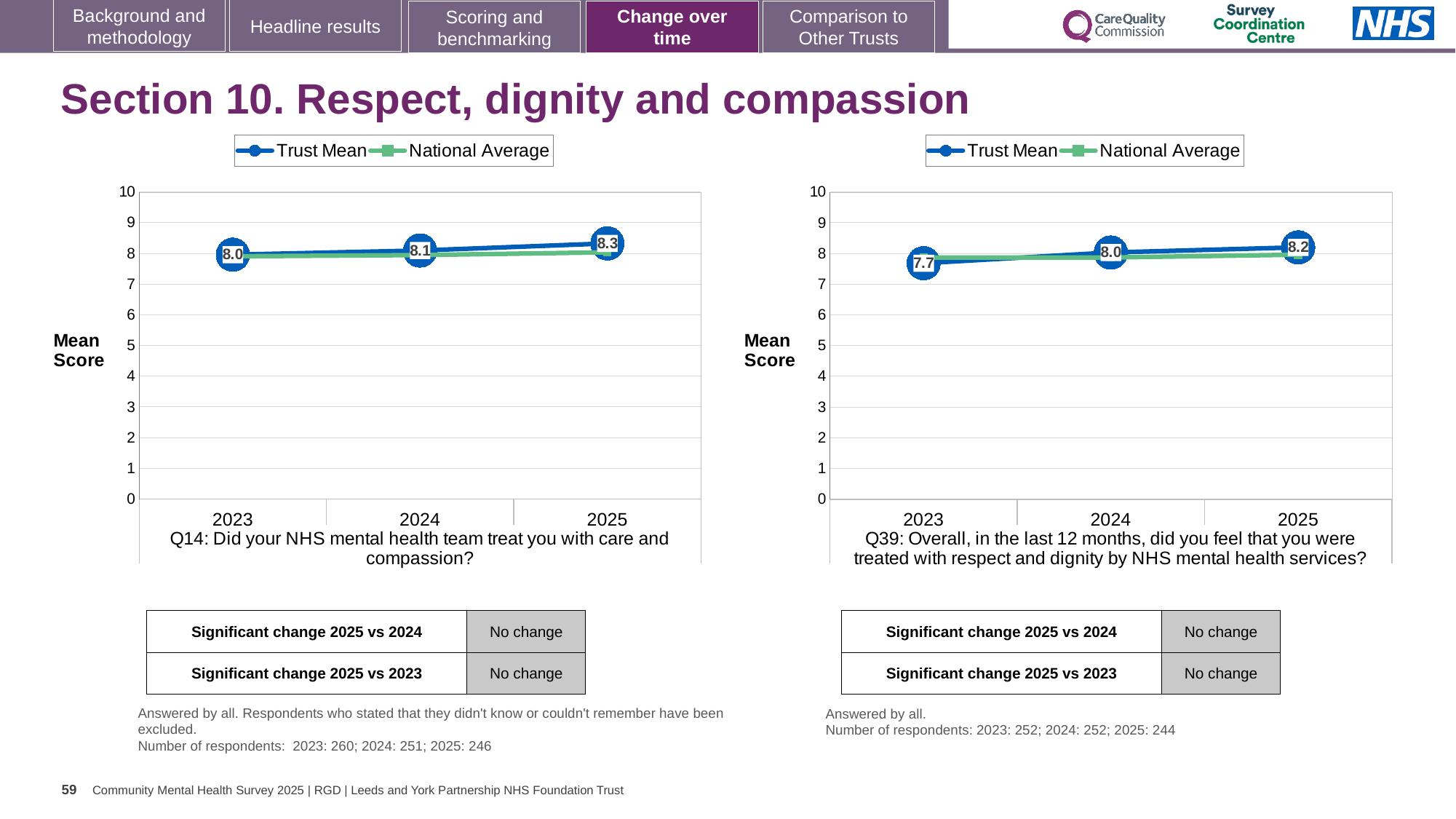
In the Q14 chart (left), does the Trust Mean rise or fall from 2023 to 2025? rise In the Q14 chart (left), what is the difference between the Trust Mean scores for 2025 and 2023? 0.3 In the Q14 chart (left), what is the Trust Mean score for 2025? 8.3 In the Q39 chart (right), is the Trust Mean score for 2023 greater or less than 8? less In the Q14 chart (left), what is the Trust Mean score for 2023? 8.0 In the Q39 chart (right), what is the Trust Mean score for 2023? 7.7 In the Q39 chart (right), which year has the lowest Trust Mean score? 2023 How many series does the legend of the Q14 chart (left) list? 2 In the Q39 chart (right), what is the difference between the Trust Mean scores for 2025 and 2023? 0.5 In the Q39 chart (right), which year has the highest Trust Mean score? 2025 In the Q39 chart (right), what is the Trust Mean score for 2024? 8.0 What kind of chart is the Q39 chart (right)? line chart